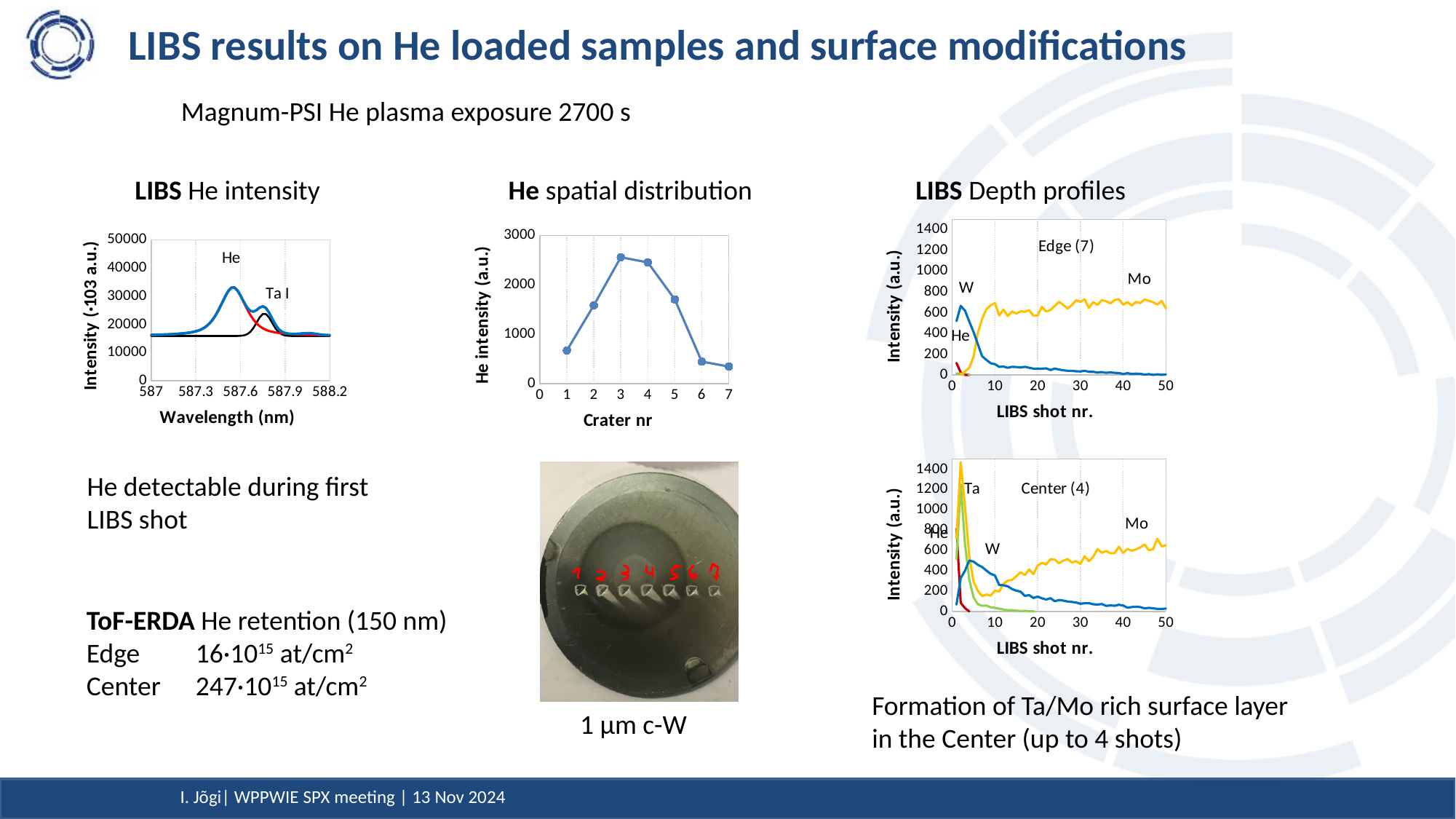
In the 'LIBS He intensity' chart, is the peak of the He line greater or less than 30000? greater In the 'LIBS Depth profiles' Edge (7) chart, does the W intensity rise or fall as the LIBS shot number increases? fall In the 'He spatial distribution' chart, what is the label of the x axis? Crater nr In the 'He spatial distribution' chart, is the He intensity for crater 1 greater or less than 1000? less In the 'LIBS Depth profiles' Center (4) chart, is the peak Ta intensity greater or less than 1200? greater In the 'He spatial distribution' chart, how many crater data points are plotted? 7 What kind of chart is the 'He spatial distribution' chart? line chart In the 'LIBS He intensity' chart, what is the label of the x axis? Wavelength (nm) In the 'He spatial distribution' chart, which has the higher He intensity, crater 2 or crater 1? crater 2